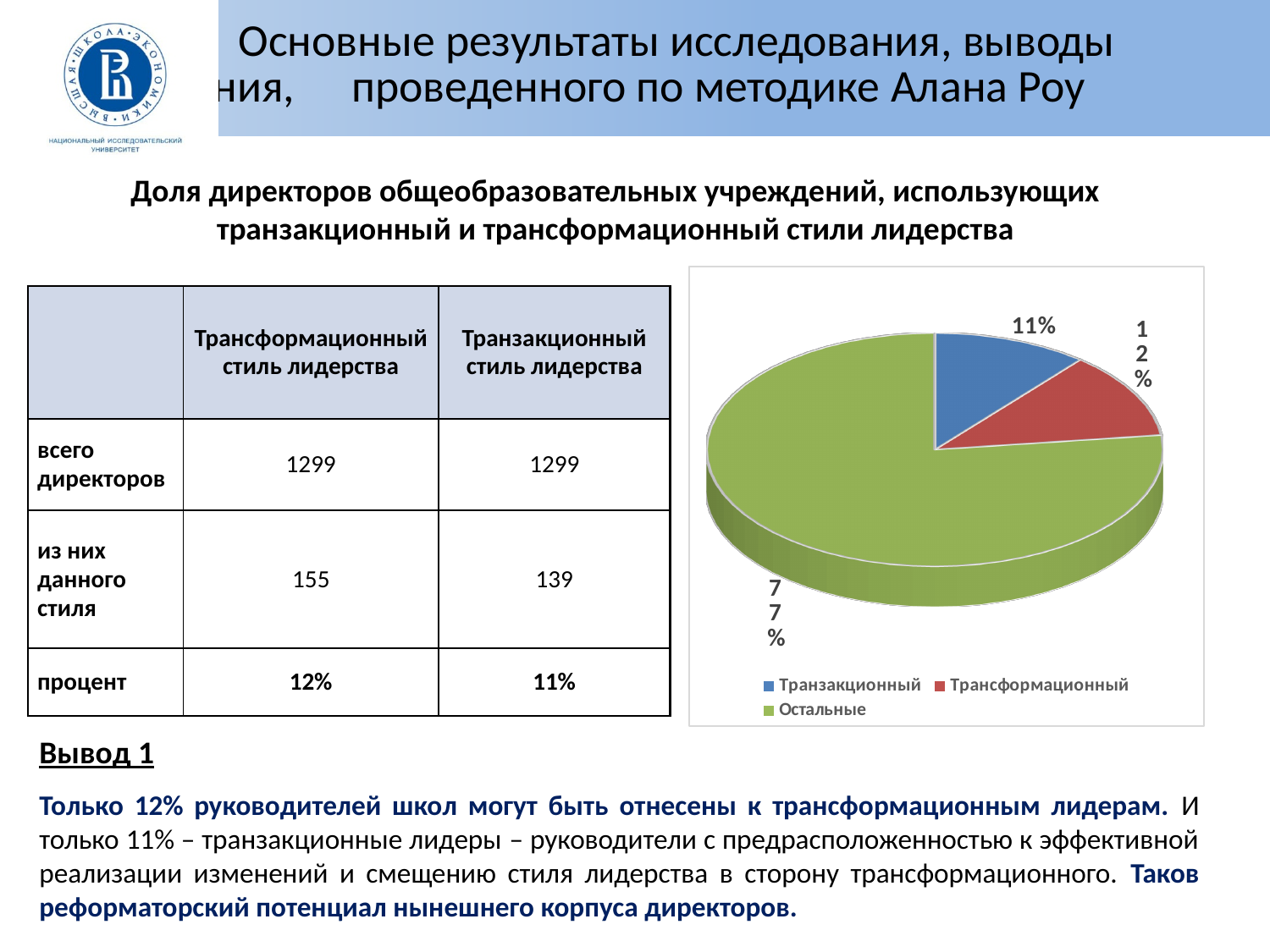
How many entries does the legend of the pie chart list? 3 Which slice of the pie chart is the largest? Остальные How many slices does the pie chart have? 3 What share of the pie does the Остальные slice represent? 77% By how many percentage points does the Трансформационный slice exceed the Транзакционный slice? 1% Which slice of the pie chart is the smallest? Транзакционный Which slice is larger, Трансформационный or Транзакционный? Трансформационный What share of the pie does the Трансформационный slice represent? 12% What colour is the Остальные slice in the pie chart? green By how many percentage points does the Остальные slice exceed the Трансформационный slice? 65% What kind of chart is shown on the slide? pie chart What share of the pie does the Транзакционный slice represent? 11%